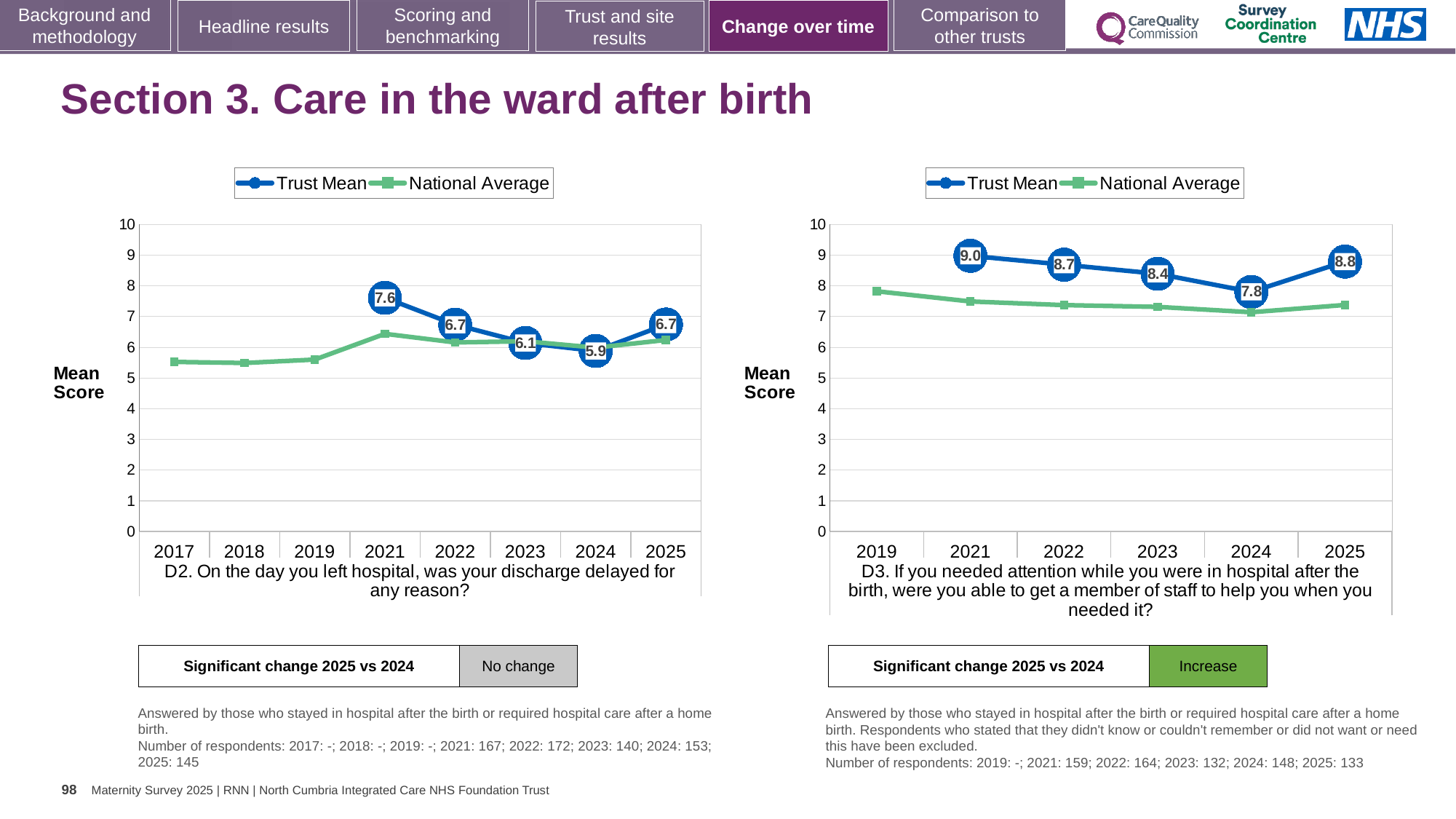
In the D2 chart (left), what is the Trust Mean score for 2021? 7.6 In the D3 chart (right), is the National Average value for 2019 greater or less than 7? greater In the D3 chart (right), what is the difference between the Trust Mean scores for 2021 and 2024? 1.2 In the D2 chart (left), which year has the highest Trust Mean score? 2021 How many years are shown on the x axis of the D3 chart (right)? 6 What kind of chart is the D3 chart (right)? Line chart How many series does the legend of the D2 chart (left) list? 2 In the D2 chart (left), what is the Trust Mean score for 2024? 5.9 In the D3 chart (right), what is the Trust Mean score for 2025? 8.8 In the D2 chart (left), is the Trust Mean score for 2022 or 2023 larger? 2022 In the D2 chart (left), is the National Average value for 2017 greater or less than 6? less In the D3 chart (right), which year has the lowest Trust Mean score? 2024